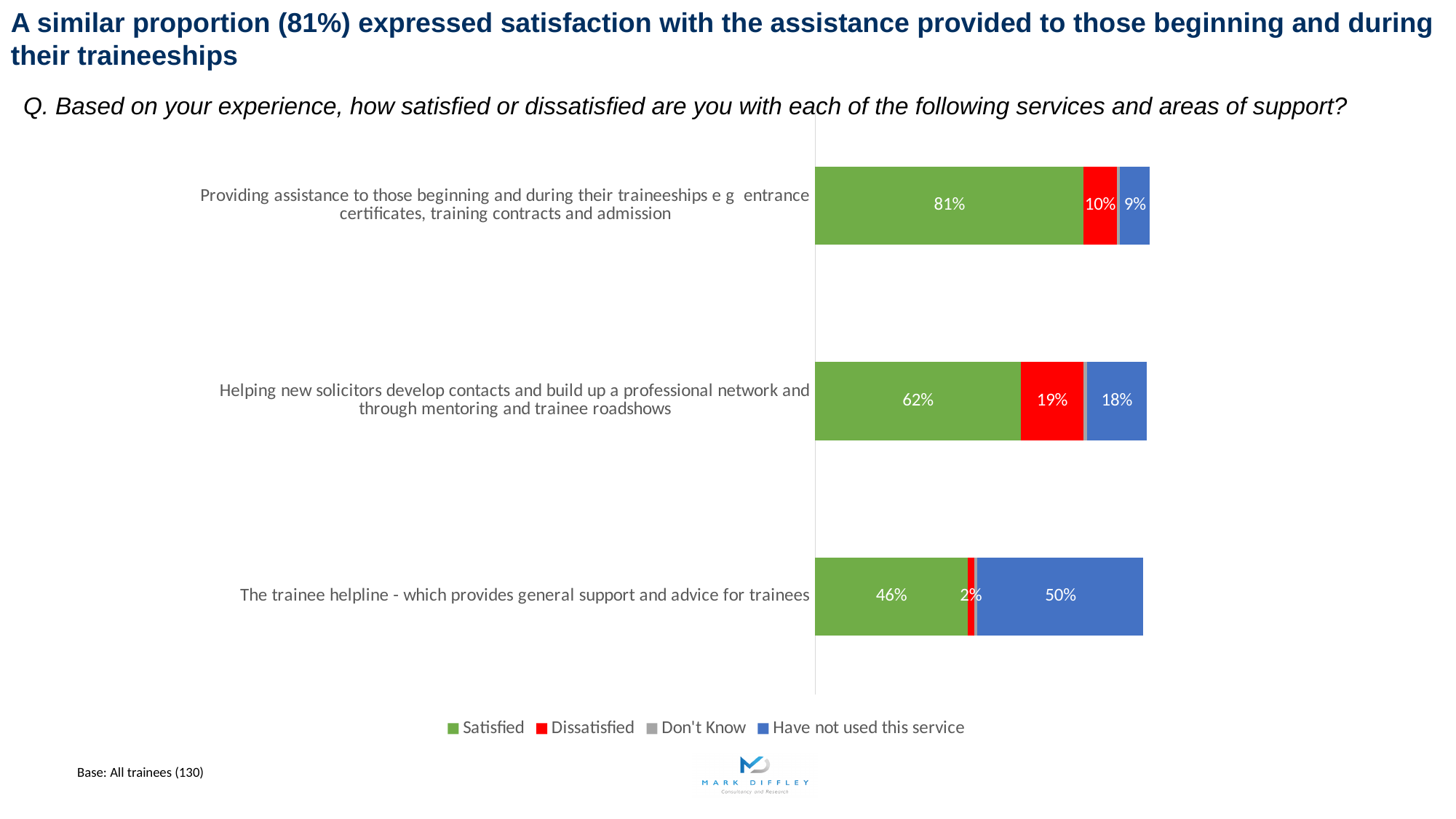
Which service has the lowest Dissatisfied percentage? The trainee helpline What percentage of trainees have not used the trainee helpline? 50% What percentage of trainees were satisfied with the trainee helpline? 46% Which service has the highest Satisfied percentage? Providing assistance to those beginning and during their traineeships What percentage of trainees were dissatisfied with help developing contacts and building a professional network? 19% What colour represents the Dissatisfied series in the chart? Red How many services are shown in the chart? 3 What type of chart is shown on the slide? Stacked bar chart What percentage of trainees have not used the service providing assistance to those beginning and during their traineeships? 9% What is the difference between the Satisfied percentages for providing assistance to those beginning their traineeships and for helping new solicitors develop contacts? 19 percentage points Is the Satisfied percentage higher for the trainee helpline or for helping new solicitors develop contacts? Helping new solicitors develop contacts How many series does the legend list? 4